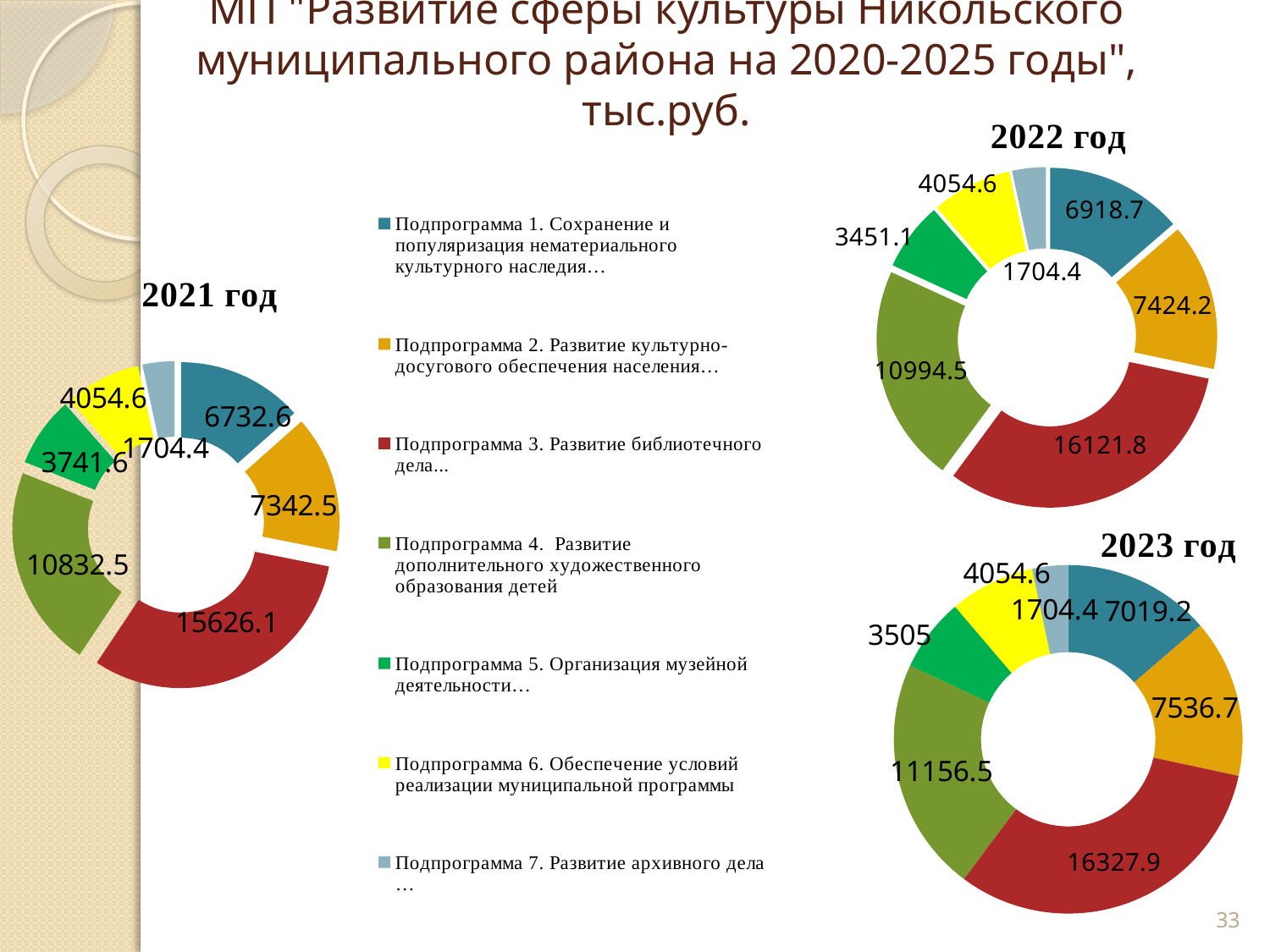
In the 2022 год chart, which subprogram has the smallest value? Подпрограмма 7. Развитие архивного дела In the 2023 год chart, which subprogram has the largest value? Подпрограмма 3. Развитие библиотечного дела In the 2022 год chart, which is larger: the value for Подпрограмма 1 or Подпрограмма 2? Подпрограмма 2 How many slices does the 2021 год chart have? 7 What is the total of all values in the 2021 год chart? 50034.3 How many entries does the legend list? 7 In the 2021 год chart, how much larger is the value for Подпрограмма 3 than for Подпрограмма 4? 4793.6 In the 2022 год chart, what is the value for Подпрограмма 4. Развитие дополнительного художественного образования детей? 10994.5 What is the difference between the value for Подпрограмма 3 in the 2023 год chart and in the 2022 год chart? 206.1 What kind of chart is the 2023 год chart? doughnut chart In the 2021 год chart, what is the value for Подпрограмма 3. Развитие библиотечного дела? 15626.1 In the 2023 год chart, what is the value for Подпрограмма 5. Организация музейной деятельности? 3505